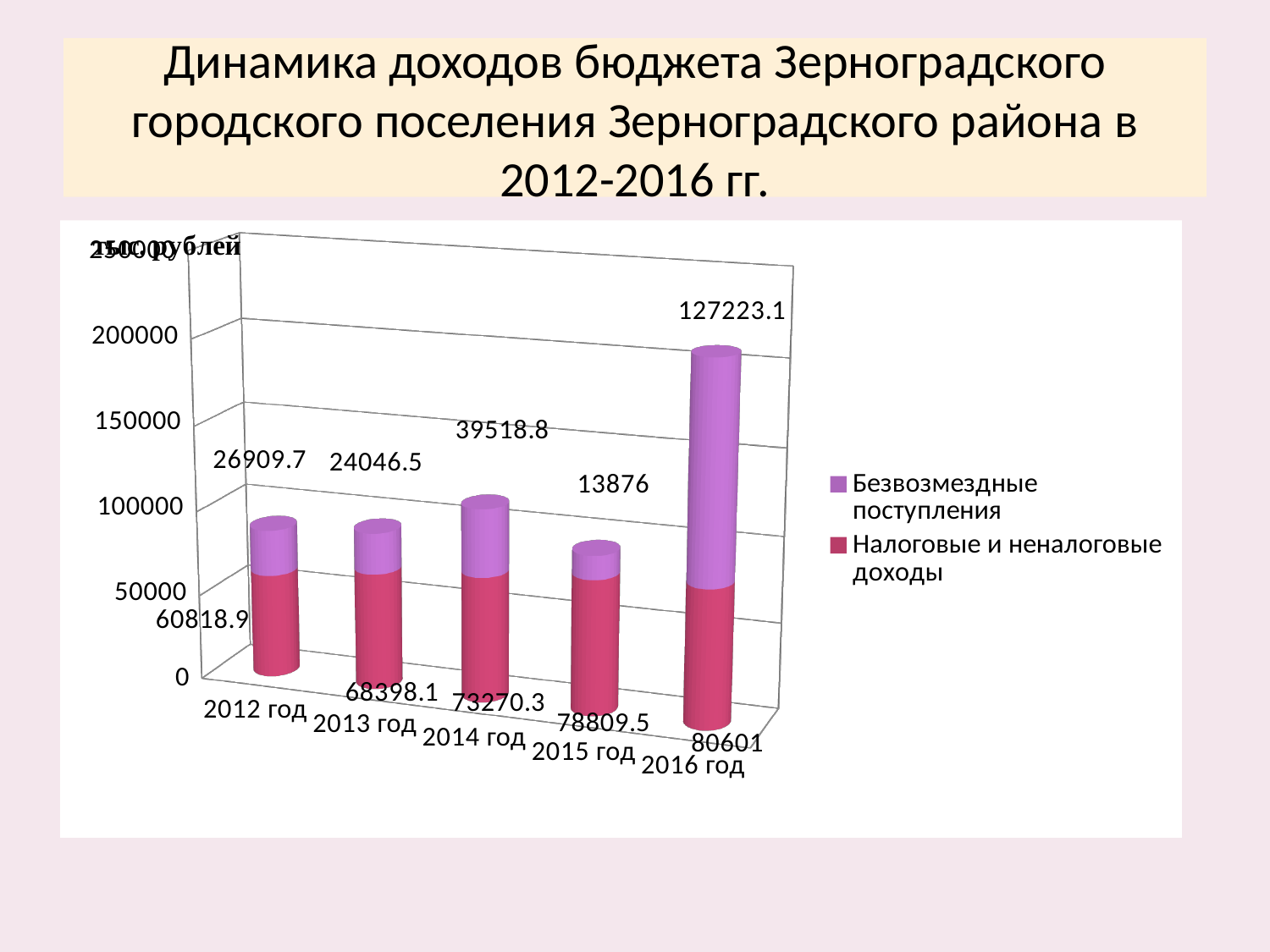
How many years (categories) are shown on the x axis? 5 What is the value of Налоговые и неналоговые доходы for 2014 год? 73270.3 What is the value of Безвозмездные поступления for 2015 год? 13876 Do the values of Налоговые и неналоговые доходы rise or fall from 2012 год to 2016 год? Rise In which year is Налоговые и неналоговые доходы the highest? 2016 год Which is larger: Безвозмездные поступления in 2014 год or in 2013 год? 2014 год What is the value of Безвозмездные поступления for 2016 год? 127223.1 What type of chart is shown on the slide? Stacked bar chart What is the total of the stacked bar for 2016 год? 207824.1 How many series does the legend list? 2 In which year is Безвозмездные поступления the lowest? 2015 год What is the difference between Налоговые и неналоговые доходы in 2013 год and 2012 год? 7579.2